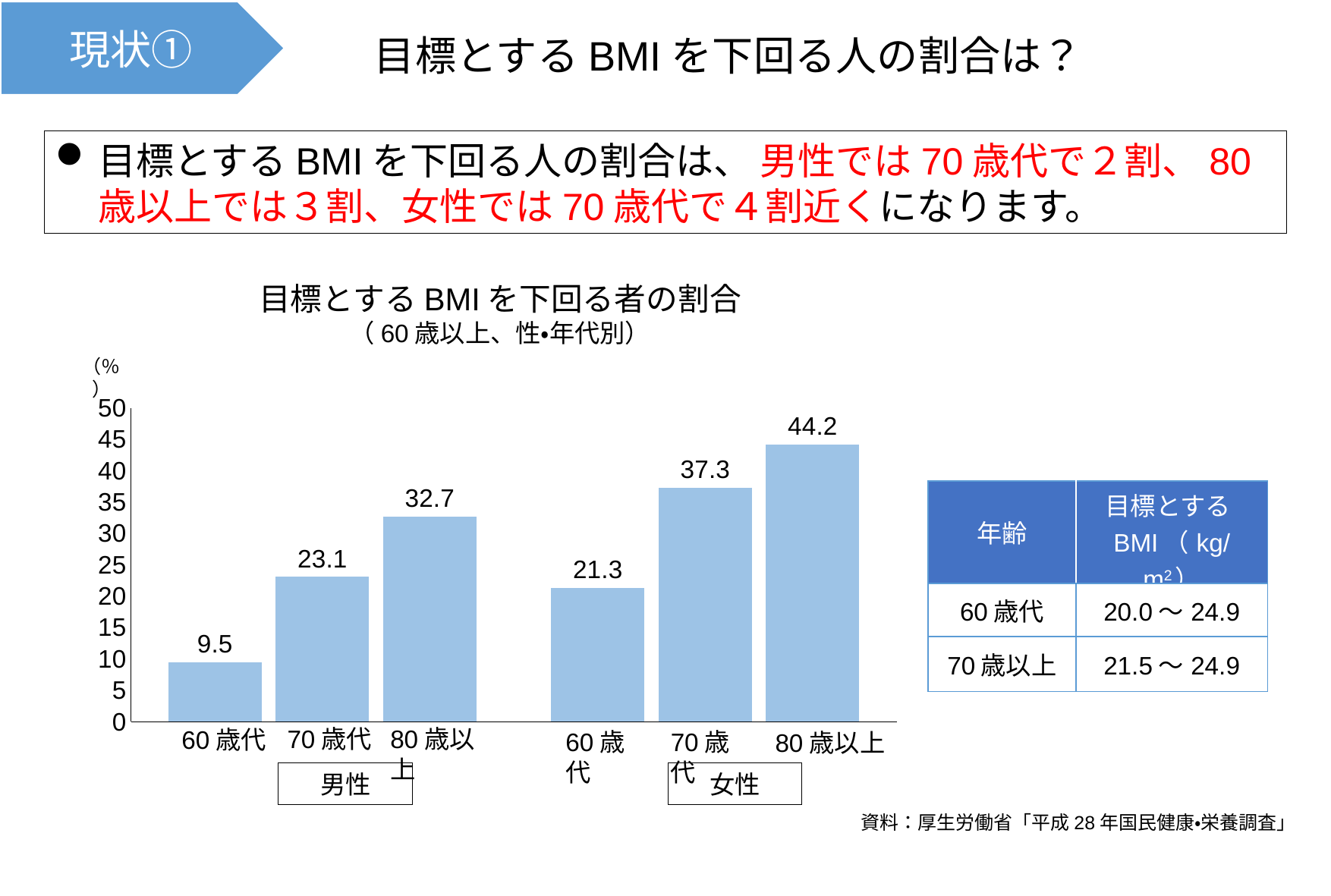
What is the value for men (男性) in their 70s (70歳代)? 23.1 Which is larger: the value for men (男性) in their 70s (70歳代) or women (女性) in their 60s (60歳代)? 男性 70歳代 Which bar has the highest value? 女性 80歳以上 What unit is shown on the vertical axis of the chart? % Within the women (女性) group, do the values rise or fall as the age group increases? Rise Which bar has the lowest value? 男性 60歳代 What is the difference between the values for women (女性) and men (男性) aged 80 and over (80歳以上)? 11.5 What kind of chart is shown? Bar chart How many bars are plotted in the chart? 6 What is the value for women (女性) aged 80 and over (80歳以上)? 44.2 What is the value for men (男性) in their 60s (60歳代)? 9.5 What is the value for women (女性) in their 70s (70歳代)? 37.3